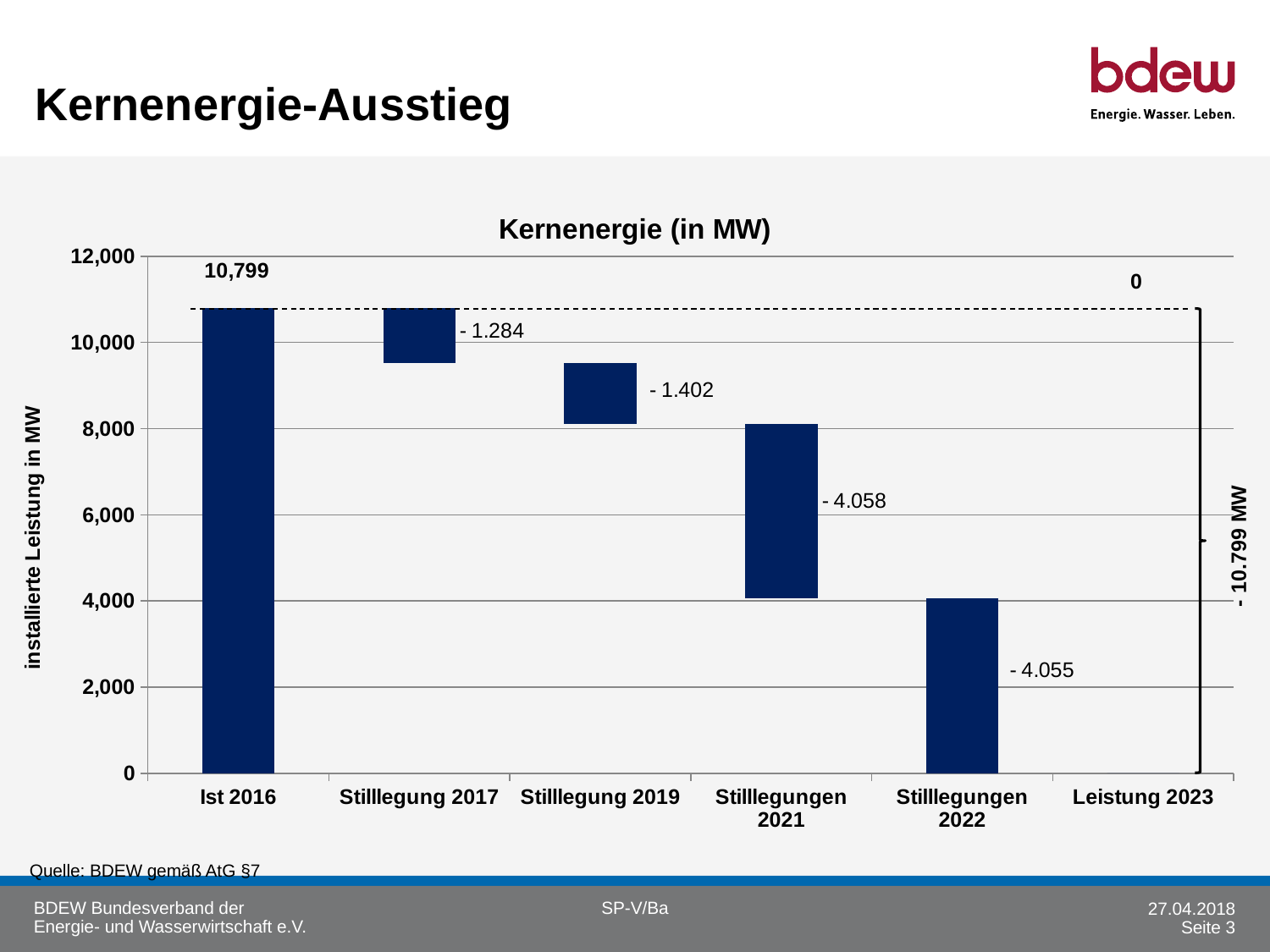
What reduction is labelled for Stilllegung 2019? - 1.402 What kind of chart is this? bar chart What is the installed capacity shown for Ist 2016? 10,799 What reduction is labelled for Stilllegungen 2022? - 4.055 What is the title of the chart? Kernenergie (in MW) What value is shown for Leistung 2023? 0 Which step shows a larger reduction, Stilllegung 2017 or Stilllegungen 2021? Stilllegungen 2021 How many categories are shown on the x axis? 6 What reduction is labelled for Stilllegungen 2021? - 4.058 What total reduction is labelled on the bracket at the right of the chart? - 10.799 MW What reduction is labelled for Stilllegung 2017? - 1.284 What is the label of the vertical axis? installierte Leistung in MW